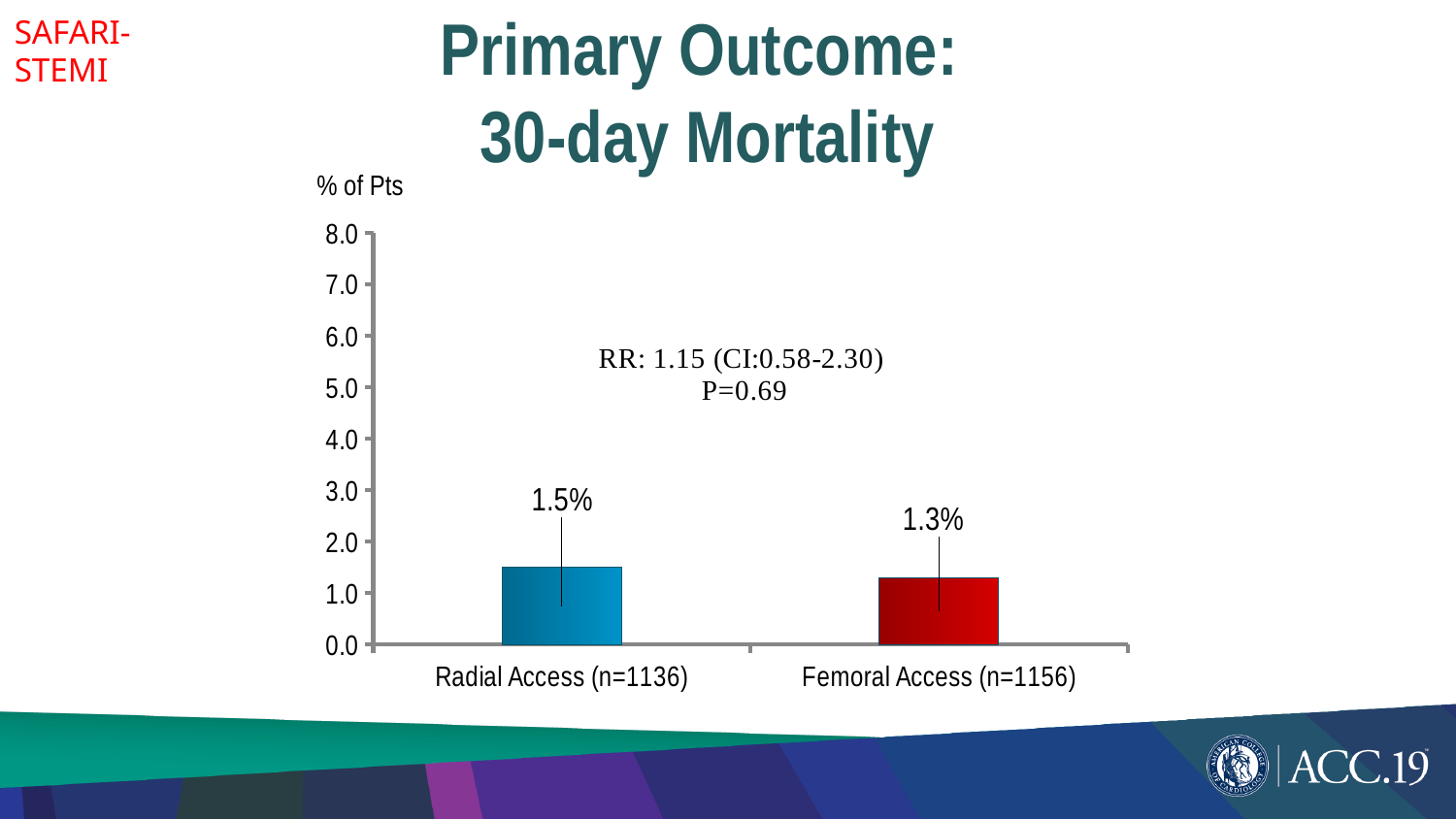
Which access group has the lower 30-day mortality? Femoral Access What is the 30-day mortality for Femoral Access? 1.3% How many categories are shown on the x axis? 2 Is the 30-day mortality for Femoral Access greater or less than 1.0? greater What kind of chart is shown on the slide? Bar chart What is the 30-day mortality for Radial Access? 1.5% Is the 30-day mortality for Radial Access greater or less than 2.0? less How many patients are in the Femoral Access group? 1156 What is the maximum value shown on the y axis? 8.0 Which access group has the higher 30-day mortality? Radial Access What is the y-axis label of the chart? % of Pts What is the difference in 30-day mortality between Radial Access and Femoral Access? 0.2%